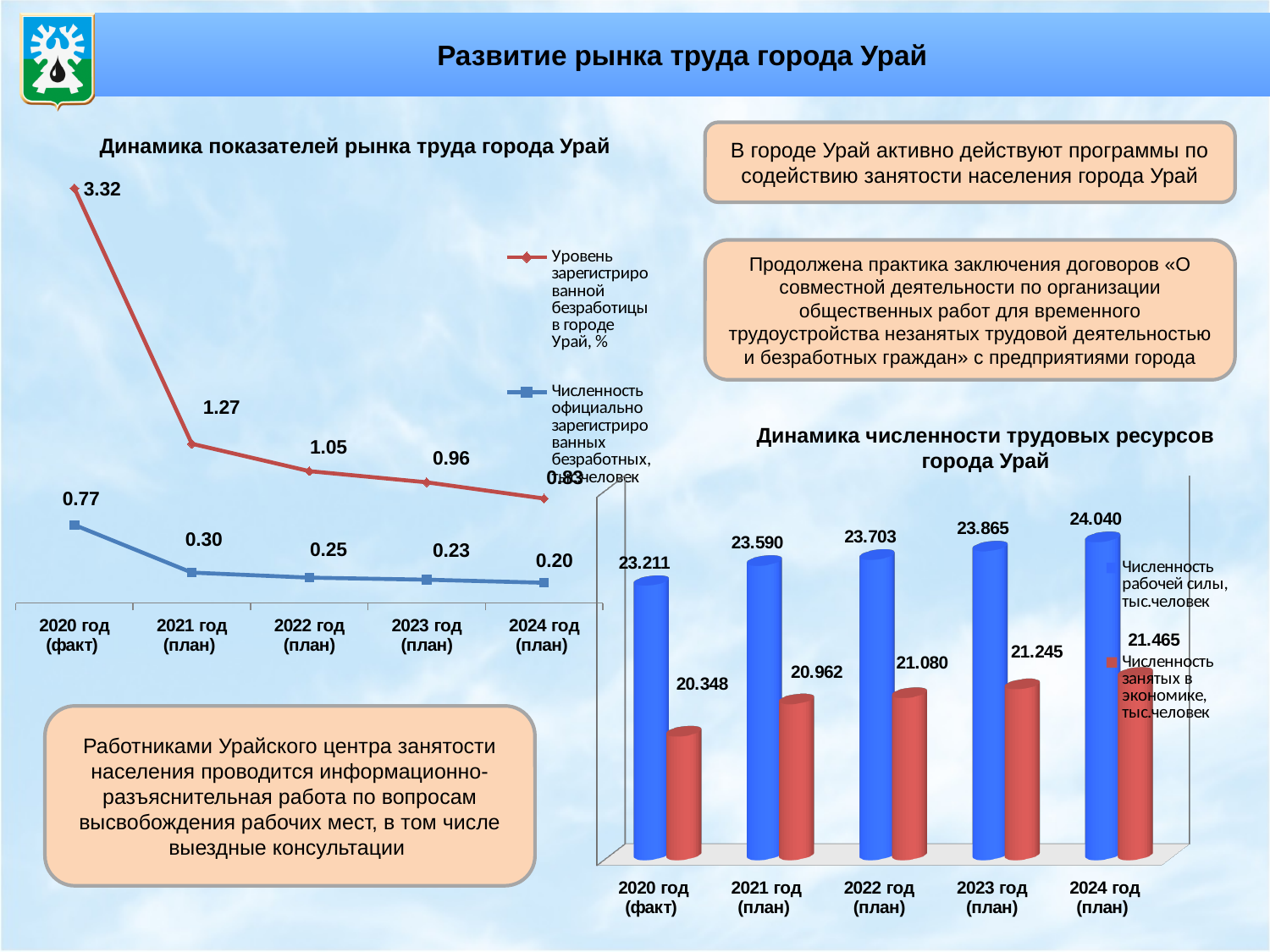
In the chart 'Динамика показателей рынка труда города Урай', what is the number of officially registered unemployed (тыс.человек) for 2022 год (план)? 0.25 In the chart 'Динамика численности трудовых ресурсов города Урай', what is the difference between the labor force and the number employed in 2024 год (план)? 2.575 In the chart 'Динамика численности трудовых ресурсов города Урай', what is the number employed in the economy for 2020 год (факт)? 20.348 In the chart 'Динамика показателей рынка труда города Урай', what is the difference between the unemployment rate in 2021 год (план) and 2022 год (план)? 0.22 In the chart 'Динамика численности трудовых ресурсов города Урай', what is the labor force (Численность рабочей силы) for 2023 год (план)? 23.865 In the chart 'Динамика показателей рынка труда города Урай', does the registered unemployment rate rise or fall from 2020 to 2024? fall What type of chart is 'Динамика показателей рынка труда города Урай'? line chart In the chart 'Динамика показателей рынка труда города Урай', what is the registered unemployment rate for 2020 год (факт)? 3.32 In the chart 'Динамика численности трудовых ресурсов города Урай', which year has the lowest number employed in the economy? 2020 год (факт) How many year categories are shown on the x axis of the chart 'Динамика численности трудовых ресурсов города Урай'? 5 How many series does the legend of the chart 'Динамика численности трудовых ресурсов города Урай' list? 2 In the chart 'Динамика показателей рынка труда города Урай', which year has the highest registered unemployment rate? 2020 год (факт)